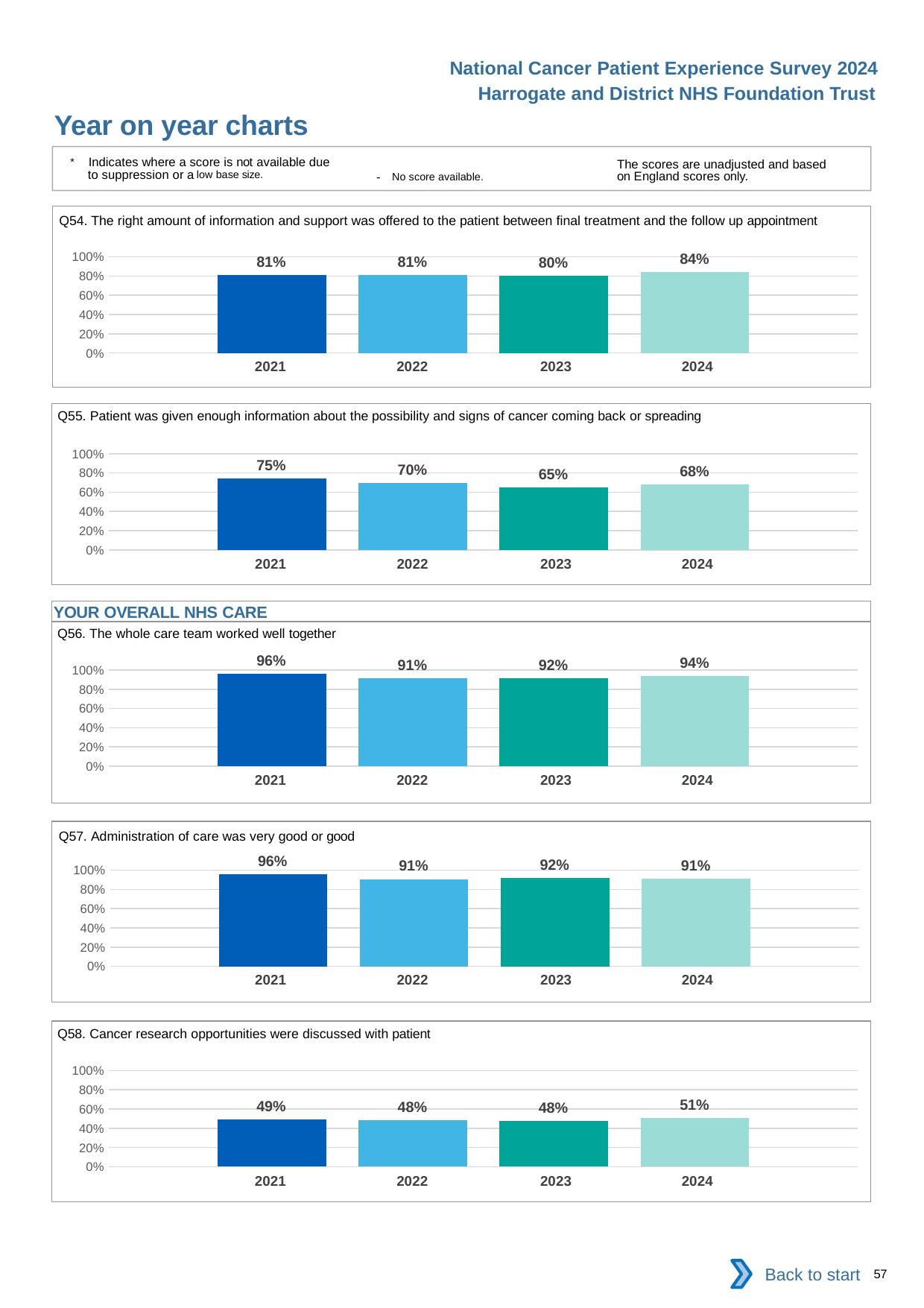
In the Q58 chart, which year has the highest value? 2024 How many years are shown on the x axis of the Q54 chart? 4 In the Q55 chart, which year has the lowest value? 2023 In the Q57 chart, is the value for 2023 larger or smaller than the value for 2024? larger In the Q55 chart, do the values rise or fall from 2021 to 2023? fall In the Q54 chart, what is the value for 2024? 84% In the Q56 chart, which year has the highest value? 2021 What kind of chart is the Q57 chart? bar chart What is the section heading shown above the Q56 chart? YOUR OVERALL NHS CARE In the Q58 chart, what is the value for 2024? 51% In the Q55 chart, what is the difference between the 2021 and 2023 values? 10% In the Q56 chart, what is the value for 2022? 91%